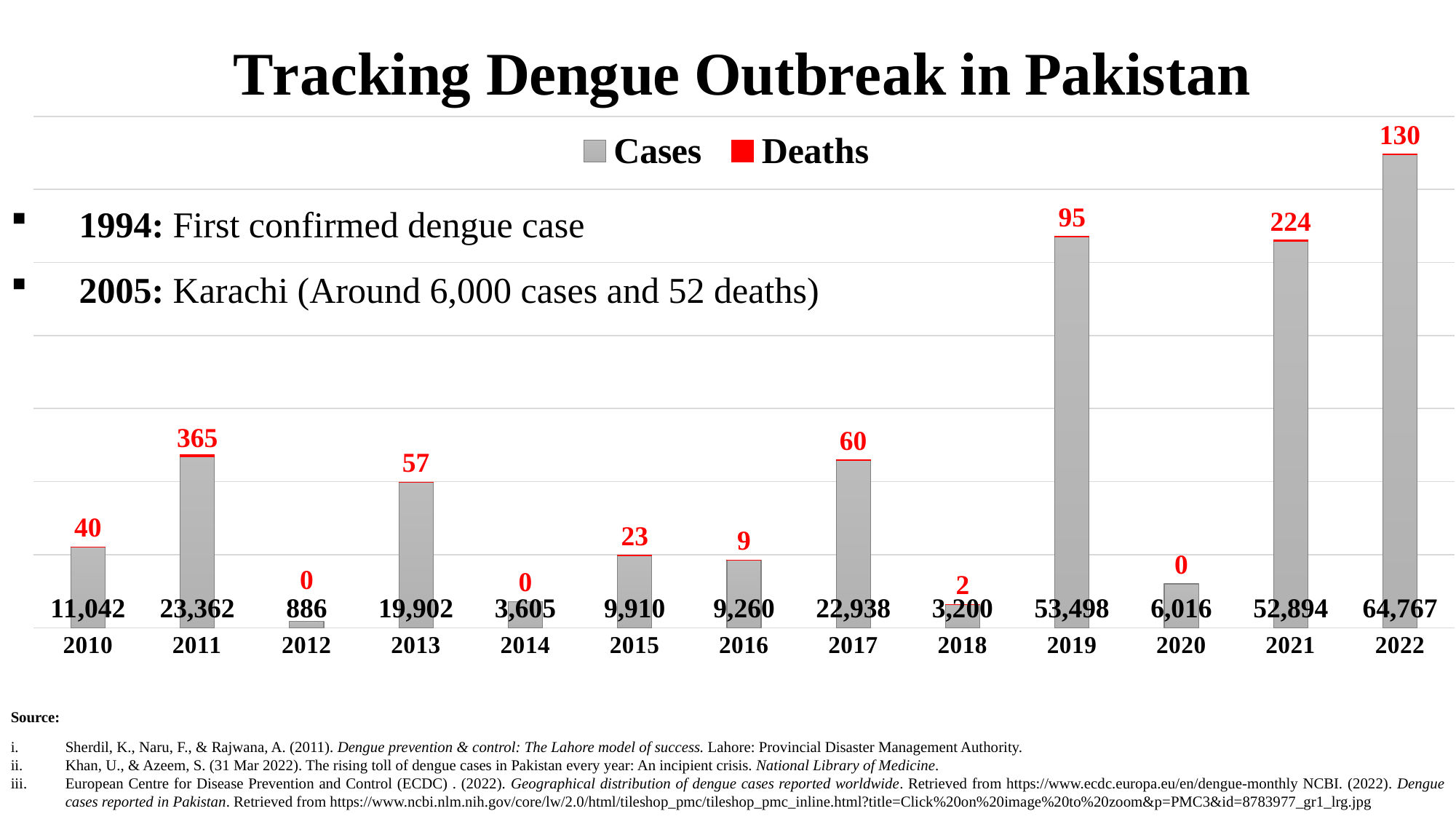
Which year had the highest number of deaths? 2011 How many deaths were reported in 2011? 365 Which year had the lowest number of cases? 2012 How many dengue cases were reported in 2012? 886 What is the total of cases and deaths for 2021? 53,118 How many dengue cases were reported in 2019? 53,498 How many series does the legend list? 2 Which year had more cases, 2013 or 2017? 2017 How many years are shown on the x axis? 13 Which year had the highest number of cases? 2022 What is the difference in cases between 2022 and 2021? 11,873 What kind of chart is shown on the slide? Bar chart